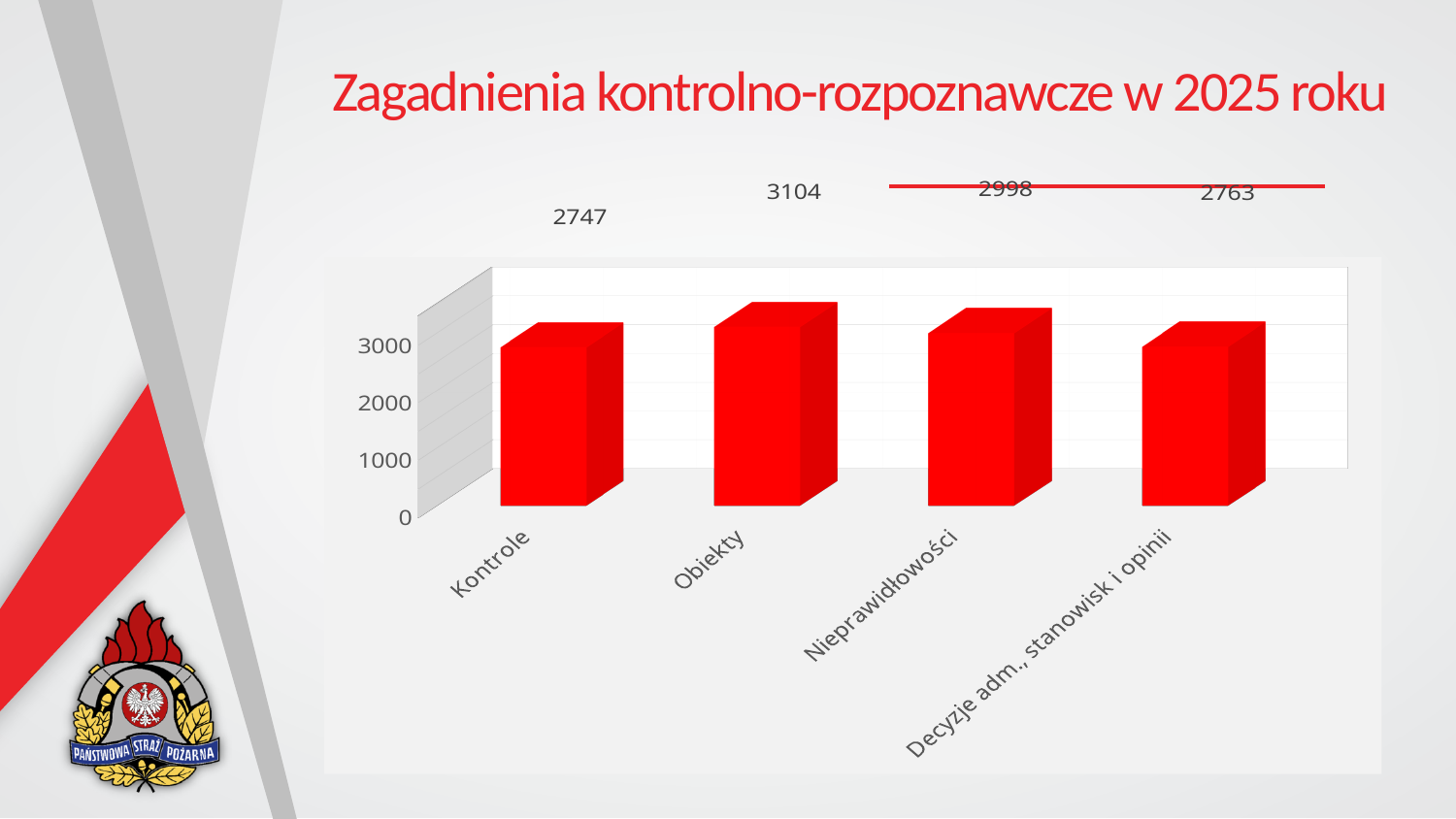
What is the value for Nieprawidłowości? 2998 How many categories are shown on the x axis? 4 Is the value for Kontrole greater or less than 3000? less What is the value for Obiekty? 3104 What is the difference between the values for Nieprawidłowości and Decyzje adm., stanowisk i opinii? 235 What is the value for Kontrole? 2747 Which is larger, the value for Obiekty or the value for Nieprawidłowości? Obiekty What kind of chart is shown on the slide? bar chart What is the difference between the values for Obiekty and Kontrole? 357 Which category has the highest value? Obiekty What is the value for Decyzje adm., stanowisk i opinii? 2763 Which category has the lowest value? Kontrole